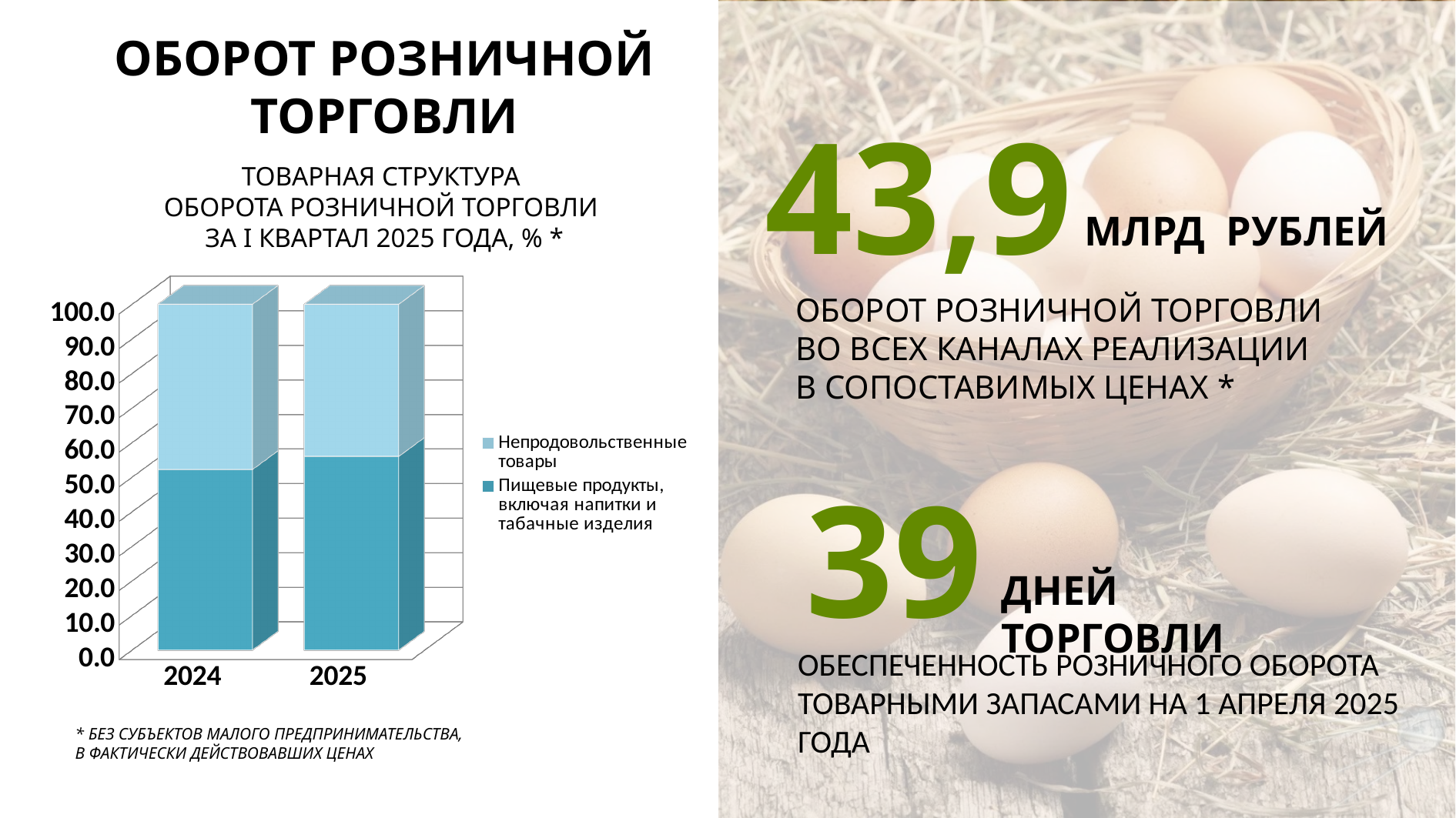
What is the total height of the stacked bar for 2024? 100.0 Is the value for Пищевые продукты, включая напитки и табачные изделия in 2024 greater or less than 60? less Does the share of Пищевые продукты, включая напитки и табачные изделия rise or fall from 2024 to 2025? rise What is the title of the chart? ТОВАРНАЯ СТРУКТУРА ОБОРОТА РОЗНИЧНОЙ ТОРГОВЛИ ЗА I КВАРТАЛ 2025 ГОДА, % * What kind of chart is shown on the slide? Stacked bar chart Is the value for Непродовольственные товары in 2025 greater or less than 50? less In 2025, which series has the larger share: Пищевые продукты, включая напитки и табачные изделия or Непродовольственные товары? Пищевые продукты, включая напитки и табачные изделия How many years (categories) are shown on the x axis of the chart? 2 Which year has the larger share of Пищевые продукты, включая напитки и табачные изделия, 2024 or 2025? 2025 How many series does the chart legend list? 2 Which series is shown at the bottom of each stacked bar? Пищевые продукты, включая напитки и табачные изделия Is the value for Пищевые продукты, включая напитки и табачные изделия in 2025 greater or less than 50? greater